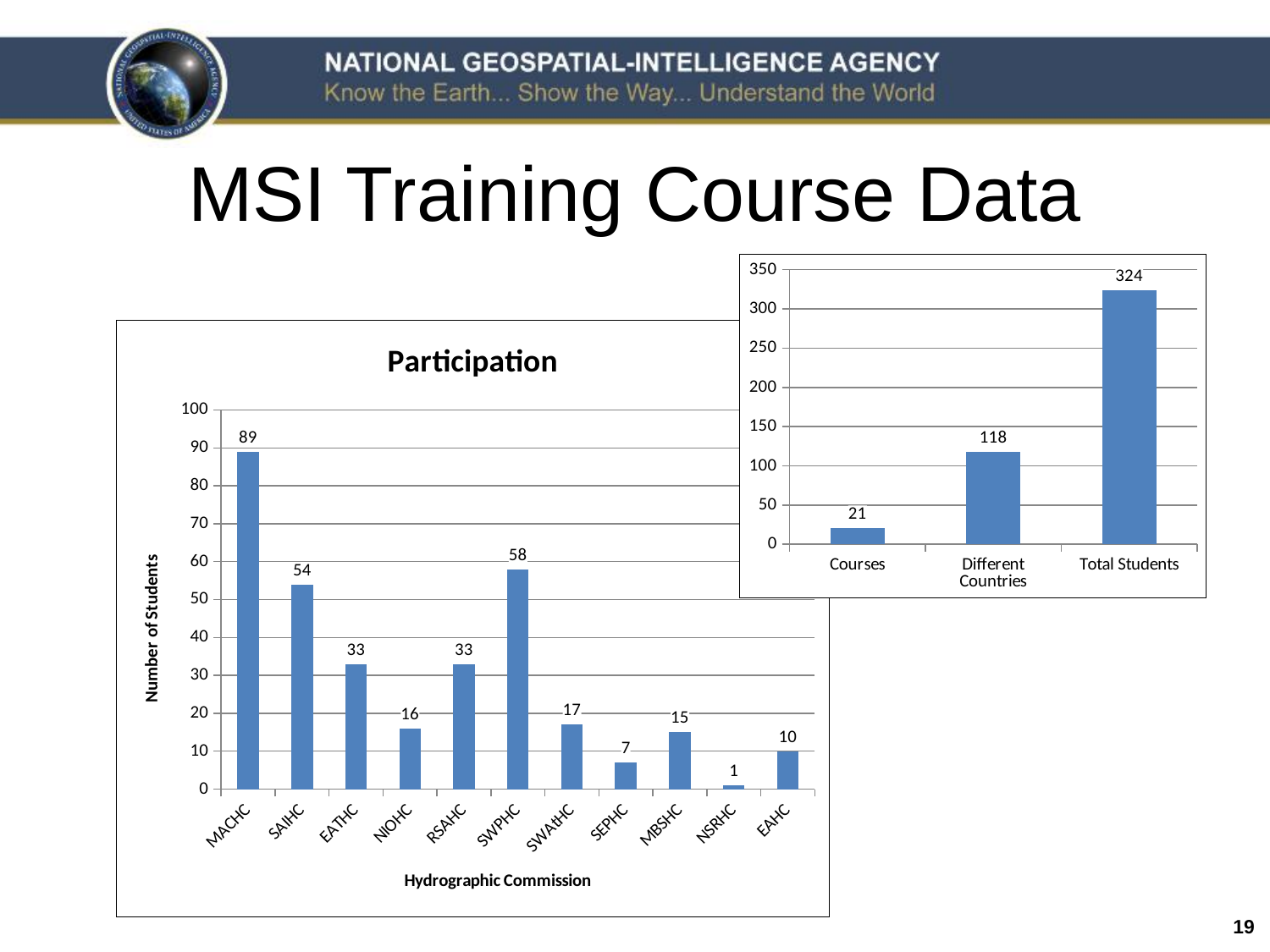
In the Participation chart, which hydrographic commission has the lowest number of students? NSRHC In the Participation chart, which hydrographic commission has the highest number of students? MACHC What type of chart is the Participation chart? bar chart How many hydrographic commissions are shown in the Participation chart? 11 In the chart at the top right, what is the value for Courses? 21 In the Participation chart, how many students are shown for MACHC? 89 In the chart at the top right, what is the value for Different Countries? 118 In the Participation chart, what is the difference between the number of students for SWPHC and SAIHC? 4 In the chart at the top right, which category has the highest value? Total Students In the chart at the top right, what is the difference between Total Students and Different Countries? 206 In the Participation chart, what is the label of the y axis? Number of Students In the Participation chart, which has more students, SWAtHC or MBSHC? SWAtHC